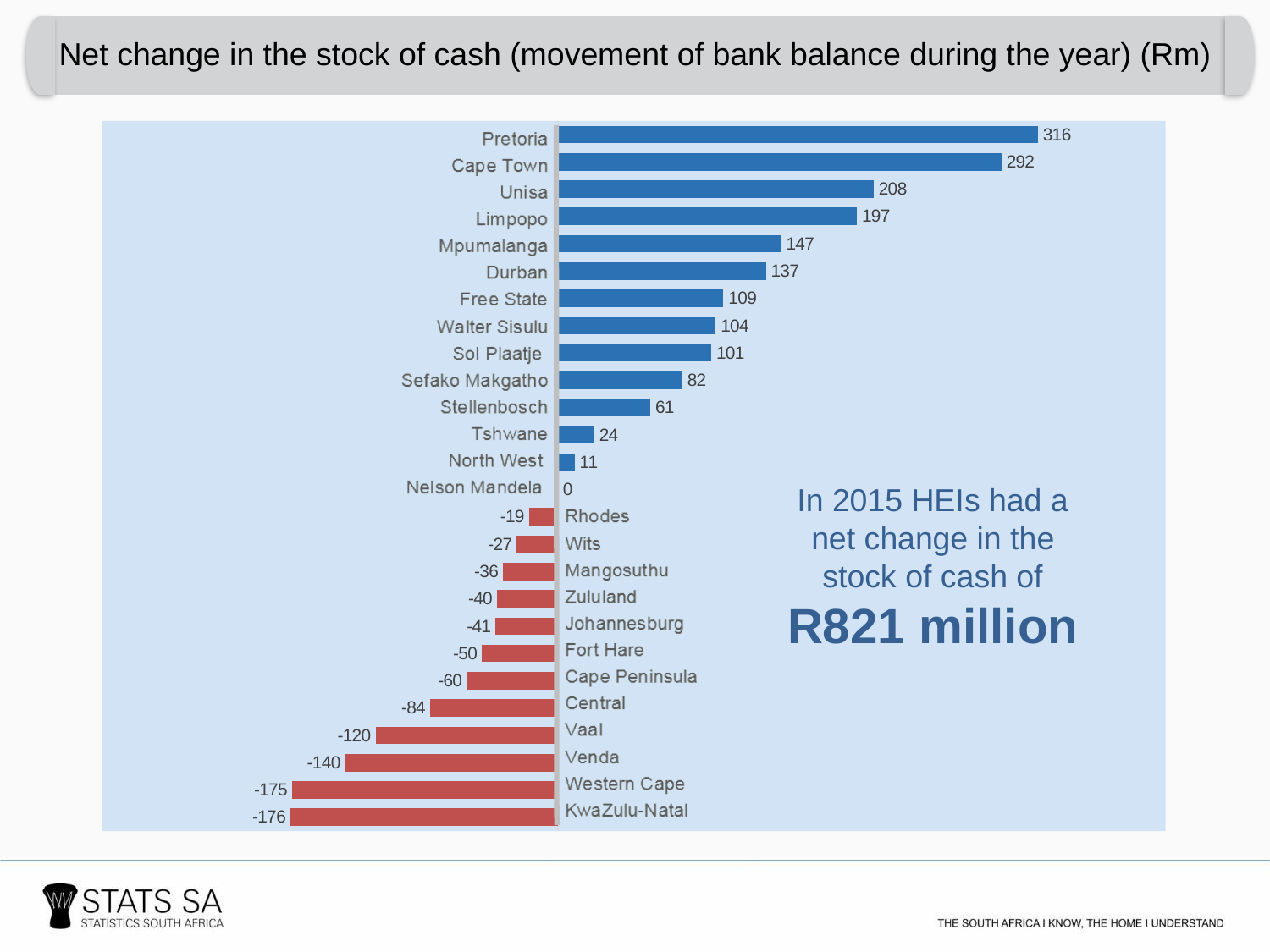
According to the text on the slide, what was the total net change in the stock of cash for HEIs in 2015? R821 million Which institution has the highest net change in the stock of cash? Pretoria What is the value shown for Venda? -140 What is the value shown for Stellenbosch? 61 What type of chart is shown on the slide? Bar chart Which has a larger value, Vaal or Central? Central What is the difference between the values for Unisa and Limpopo? 11 What is the net change in the stock of cash for Pretoria? 316 How many institutions are shown in the chart? 26 Which has a larger value, Mpumalanga or Durban? Mpumalanga What is the difference between the values for Pretoria and Cape Town? 24 What is the value shown for Nelson Mandela? 0